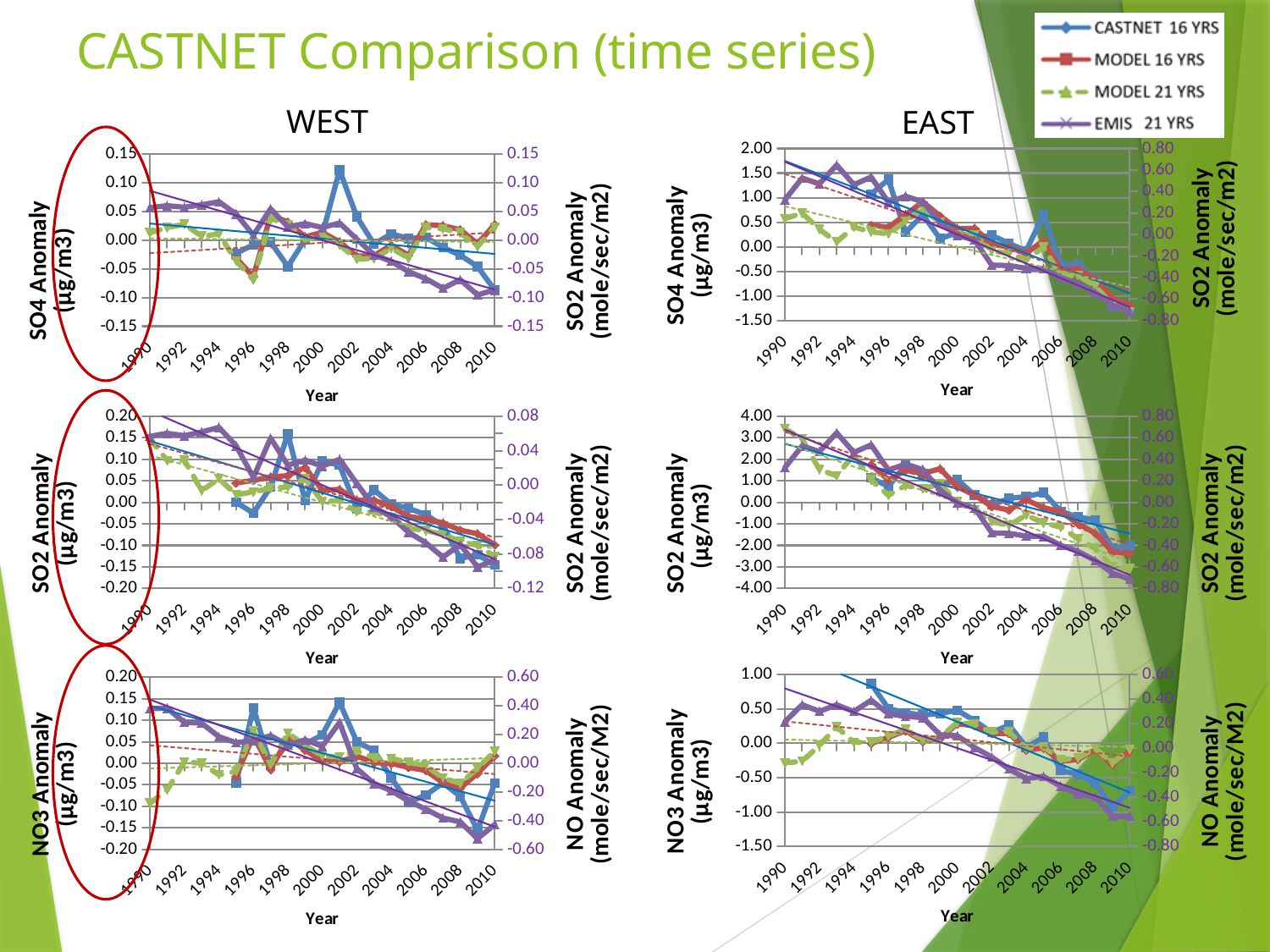
What kind of chart is the WEST SO4 Anomaly chart? line chart In the WEST SO4 Anomaly chart, is the CASTNET 16 YRS peak value around 2001 greater or less than 0.10 on the left axis? greater In the EAST NO3 Anomaly chart, is the CASTNET 16 YRS value in 2010 greater or less than 0.00 on the left axis? less In the WEST NO3 Anomaly chart, is the EMIS 21 YRS value in 2009 greater or less than 0.00 on the right axis? less How many charts are shown on the slide? 6 In the EAST SO4 Anomaly chart, does the MODEL 16 YRS series rise or fall from 1990 to 2010? fall What are the headings of the left and right columns of charts? WEST and EAST How many series does the legend list? 4 In the WEST SO2 Anomaly chart, does the EMIS 21 YRS series rise or fall from 1990 to 2010? fall What is the x-axis label on the charts? Year